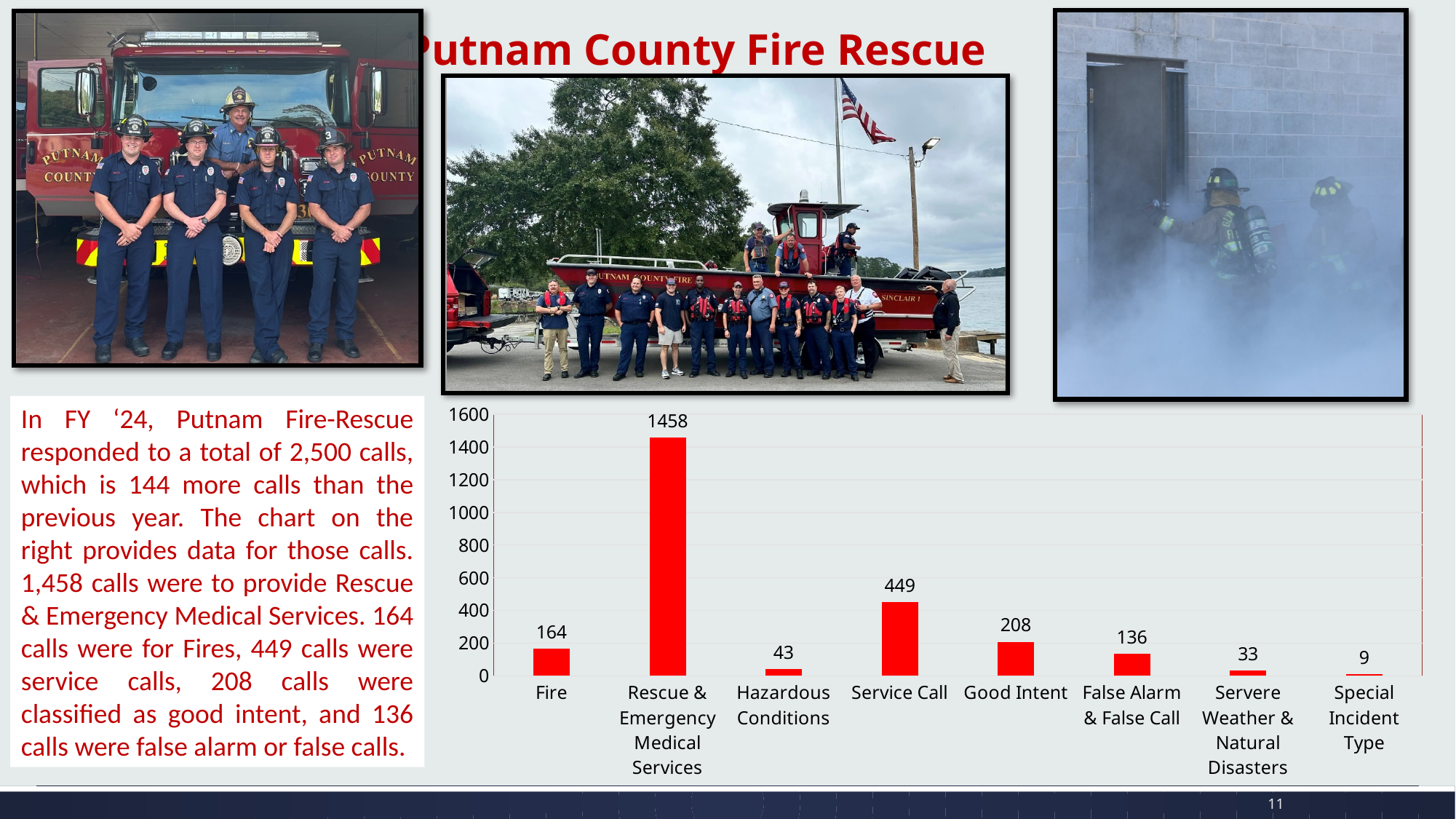
What is the difference between the Service Call value and the Good Intent value? 241 What is the value for Special Incident Type? 9 Which category has the lowest value? Special Incident Type What kind of chart is shown on the slide? bar chart What is the value for Hazardous Conditions? 43 How many calls are shown for Rescue & Emergency Medical Services? 1458 What is the value for Fire in the chart? 164 Which is larger, False Alarm & False Call or Fire? Fire Is the value for Service Call greater or less than 400? greater How many categories are shown on the x axis? 8 Which category has the highest value? Rescue & Emergency Medical Services What colour are the bars in the chart? red